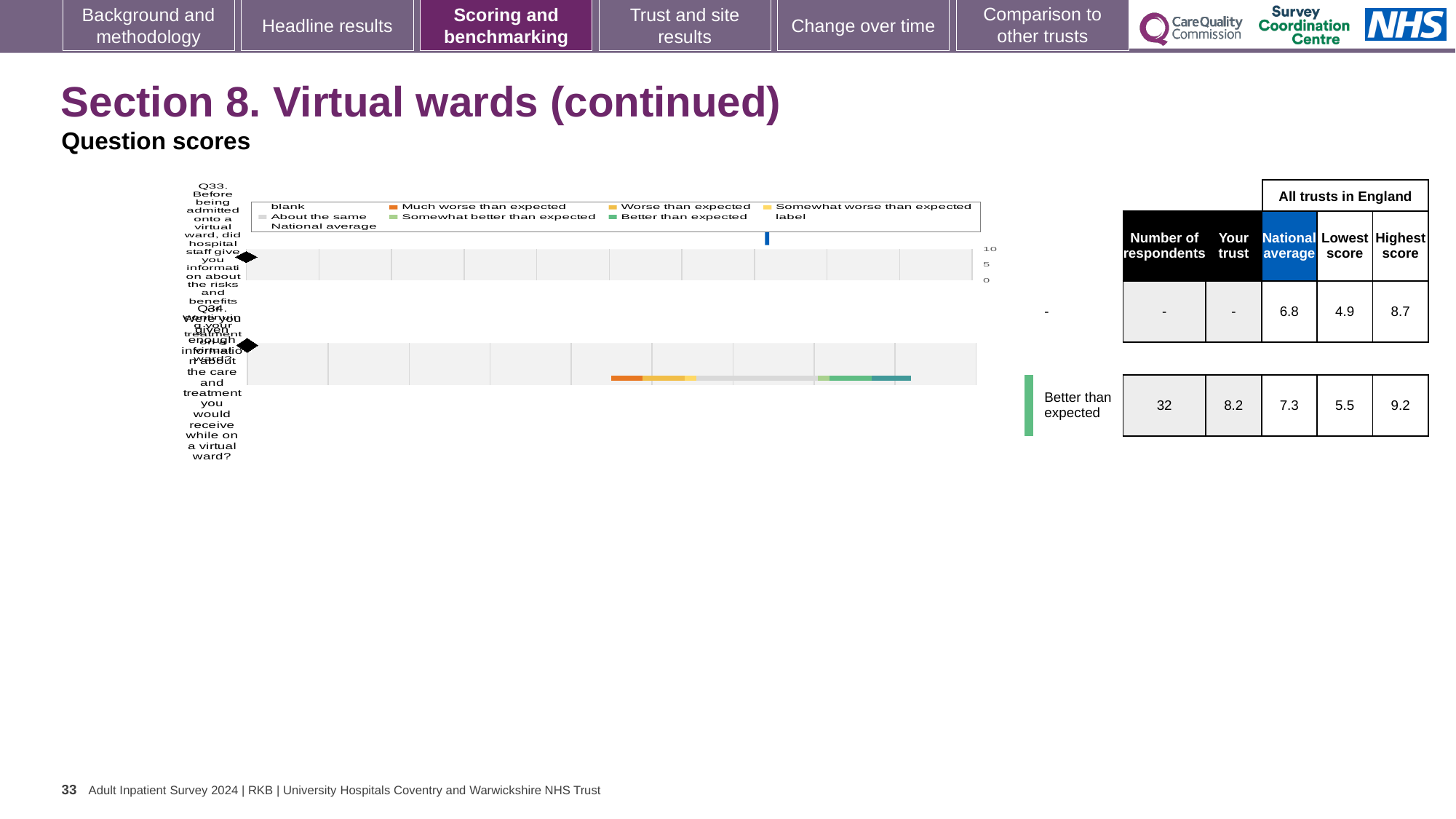
What colour does the legend use for 'Much worse than expected'? orange What is the highest value shown on the chart's axis? 10 What kind of chart is shown on the slide? bar chart How many question categories (rows) does the chart show? 2 Which question number is the first category listed on the chart? Q33